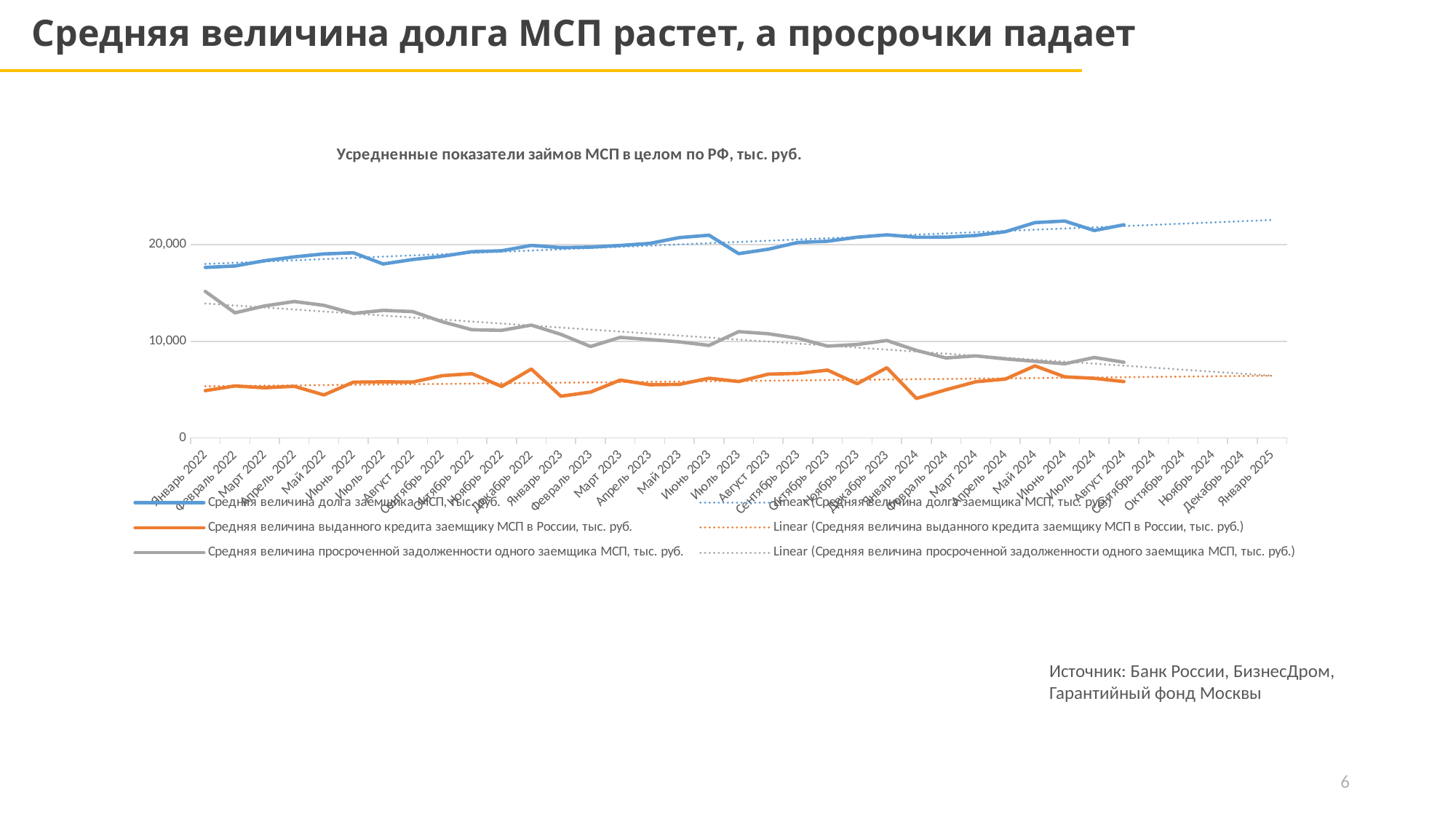
Is the value of 'Средняя величина долга заемщика МСП, тыс. руб.' in Июнь 2024 greater or less than 20,000? greater Does the series 'Средняя величина долга заемщика МСП, тыс. руб.' rise or fall from Январь 2022 to Сентябрь 2024? rise What is the title of the chart? Усредненные показатели займов МСП в целом по РФ, тыс. руб. Is the value of 'Средняя величина просроченной задолженности одного заемщика МСП, тыс. руб.' in Январь 2022 greater or less than 10,000? greater Which colour is used for the series 'Средняя величина долга заемщика МСП, тыс. руб.'? blue Is the value of 'Средняя величина долга заемщика МСП, тыс. руб.' in Январь 2022 greater or less than 20,000? less Which series has the highest values throughout the chart? Средняя величина долга заемщика МСП, тыс. руб. In Январь 2022, which is larger: the value of 'Средняя величина долга заемщика МСП, тыс. руб.' or 'Средняя величина просроченной задолженности одного заемщика МСП, тыс. руб.'? Средняя величина долга заемщика МСП, тыс. руб. Does the series 'Средняя величина просроченной задолженности одного заемщика МСП, тыс. руб.' rise or fall from Январь 2022 to Сентябрь 2024? fall What kind of chart is shown on the slide? line chart How many entries does the chart legend list? 6